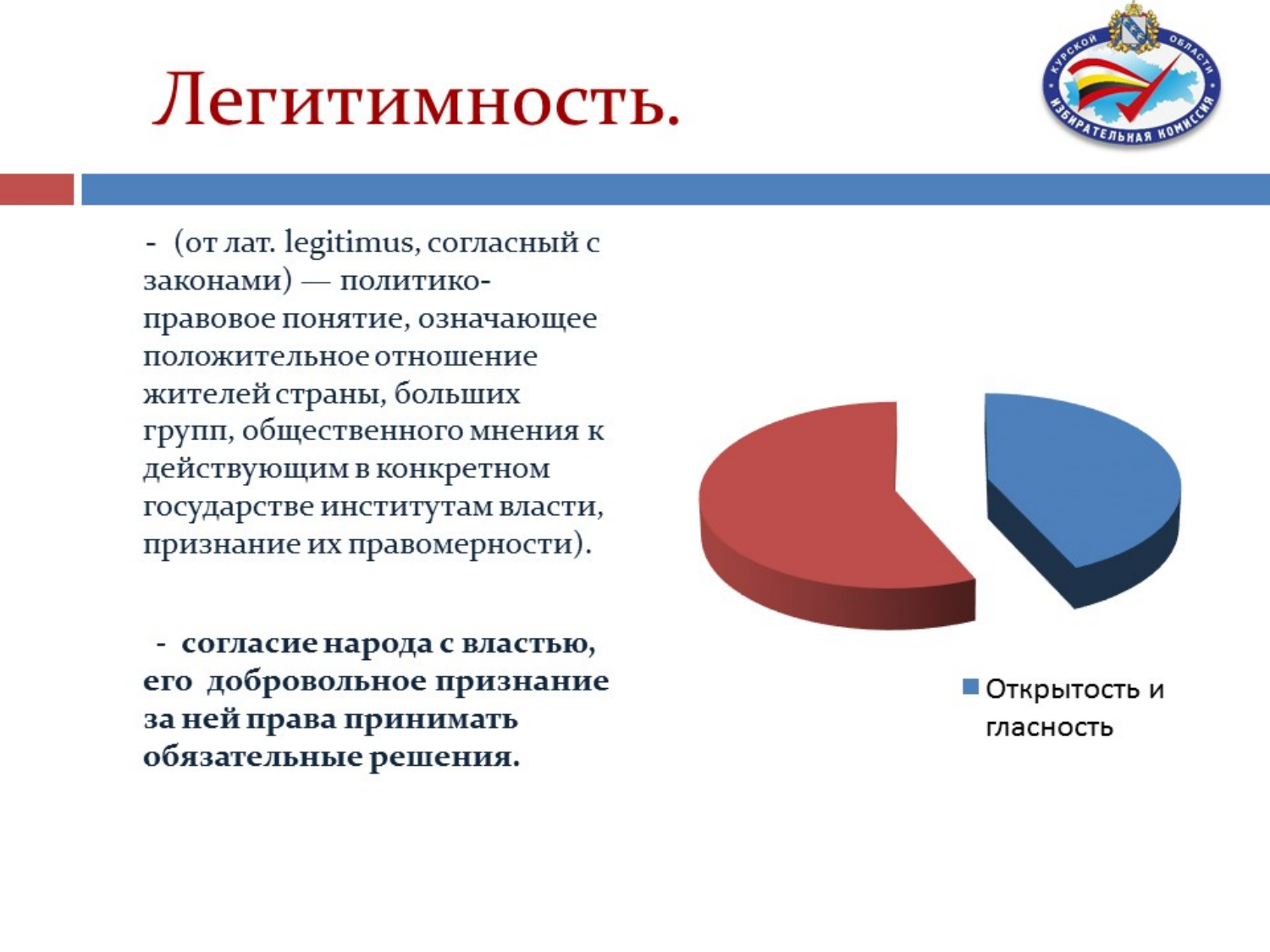
How many entries does the legend of the pie chart list? 1 Is the slice for 'Открытость и гласность' the larger or the smaller slice of the pie chart? smaller What is the legend entry shown for the pie chart? Открытость и гласность Which slice of the pie chart is larger, the red slice or the blue slice? the red slice How many slices does the pie chart have? 2 Which colour slice takes up the largest share of the pie chart? red What kind of chart is shown on the slide? pie chart What colour is the slice labelled 'Открытость и гласность' in the pie chart? blue Which slice of the pie chart is the smallest? Открытость и гласность (blue)